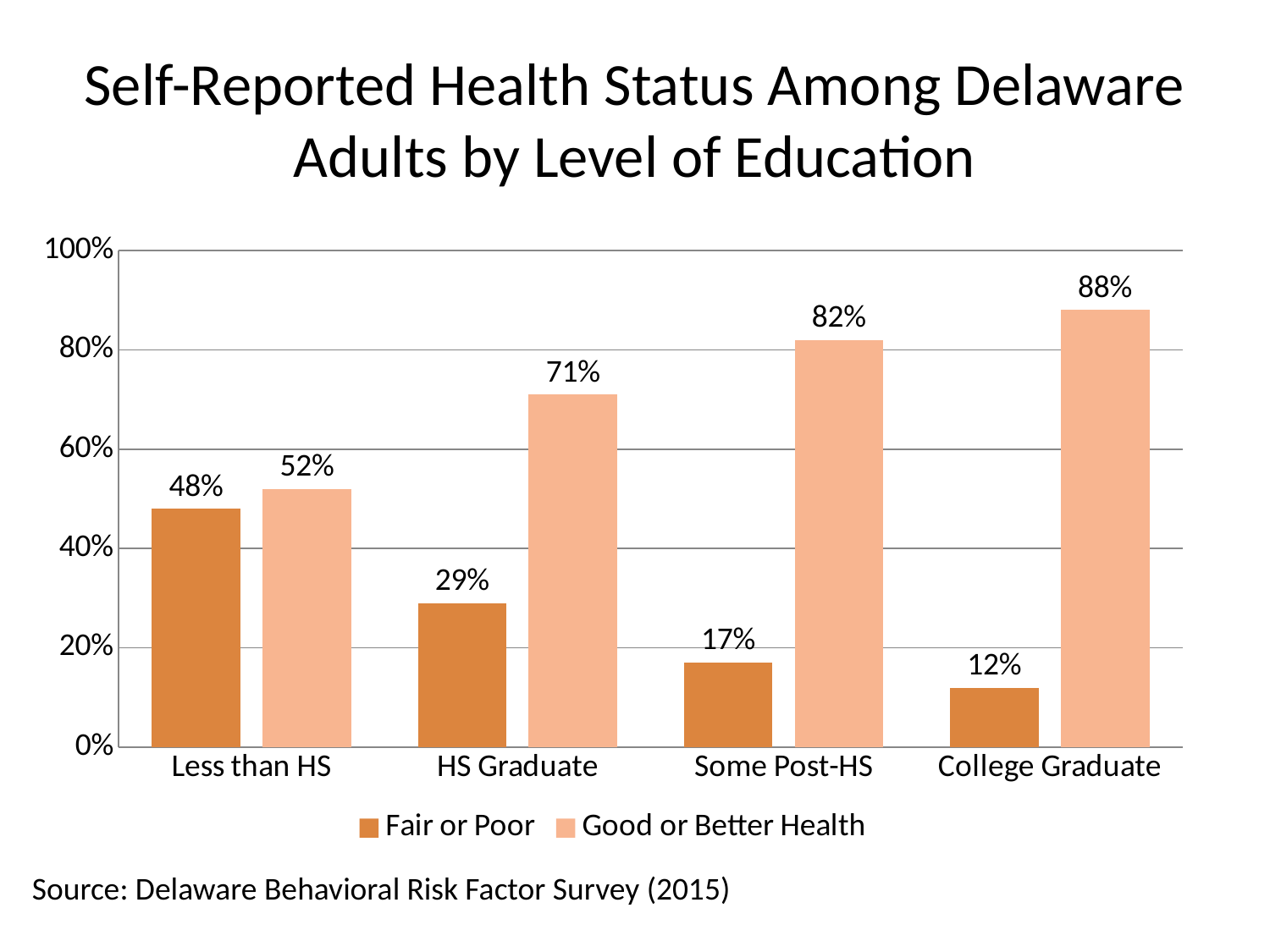
How many series does the legend list? 2 Is the Good or Better Health value for HS Graduate greater or less than 60%? greater Which is larger for Less than HS: Fair or Poor or Good or Better Health? Good or Better Health What is the difference between the Good or Better Health values for College Graduate and Less than HS? 36% What is the Fair or Poor value for College Graduate? 12% What is the Good or Better Health value for Some Post-HS? 82% Do the Fair or Poor values rise or fall from Less than HS to College Graduate? Fall Which education level has the highest Good or Better Health value? College Graduate How many education levels are shown on the x axis? 4 What is the Fair or Poor value for HS Graduate? 29% Which education level has the lowest Fair or Poor value? College Graduate What kind of chart is shown on the slide? Bar chart